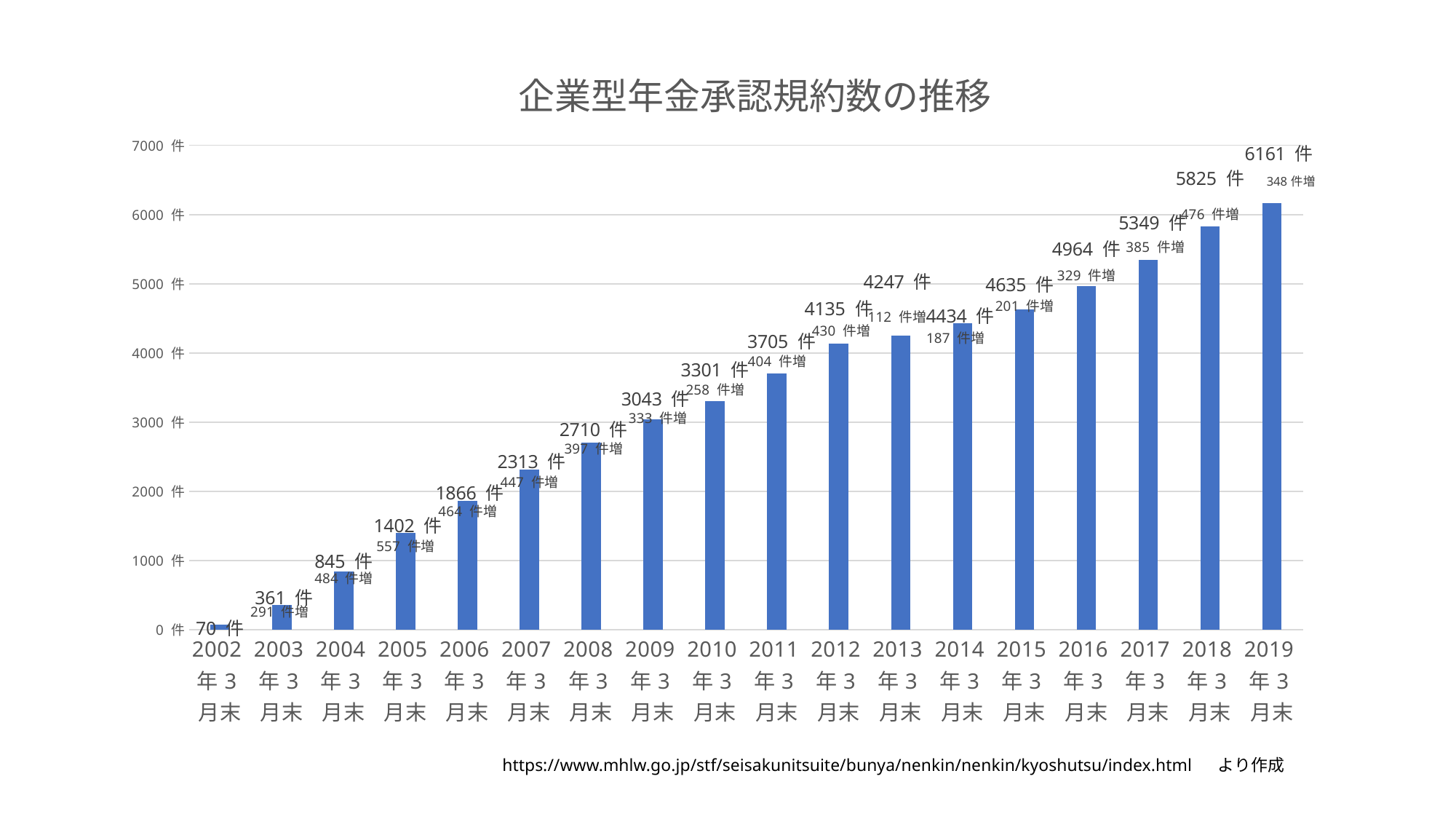
What is the difference between the values for 2008年3月末 and 2007年3月末? 397 件 Is the value for 2016年3月末 greater or less than 5000? less Which year has the highest value? 2019年3月末 What is the value for 2010年3月末? 3301 件 How many years are shown on the x axis? 18 Which is larger, the value for 2012年3月末 or the value for 2013年3月末? 2013年3月末 Which year has the lowest value? 2002年3月末 What is the value for 2005年3月末? 1402 件 What kind of chart is this? bar chart What is the difference between the values for 2019年3月末 and 2018年3月末? 336 件 Do the values rise or fall from 2002 to 2019? rise What is the value for 2019年3月末? 6161 件